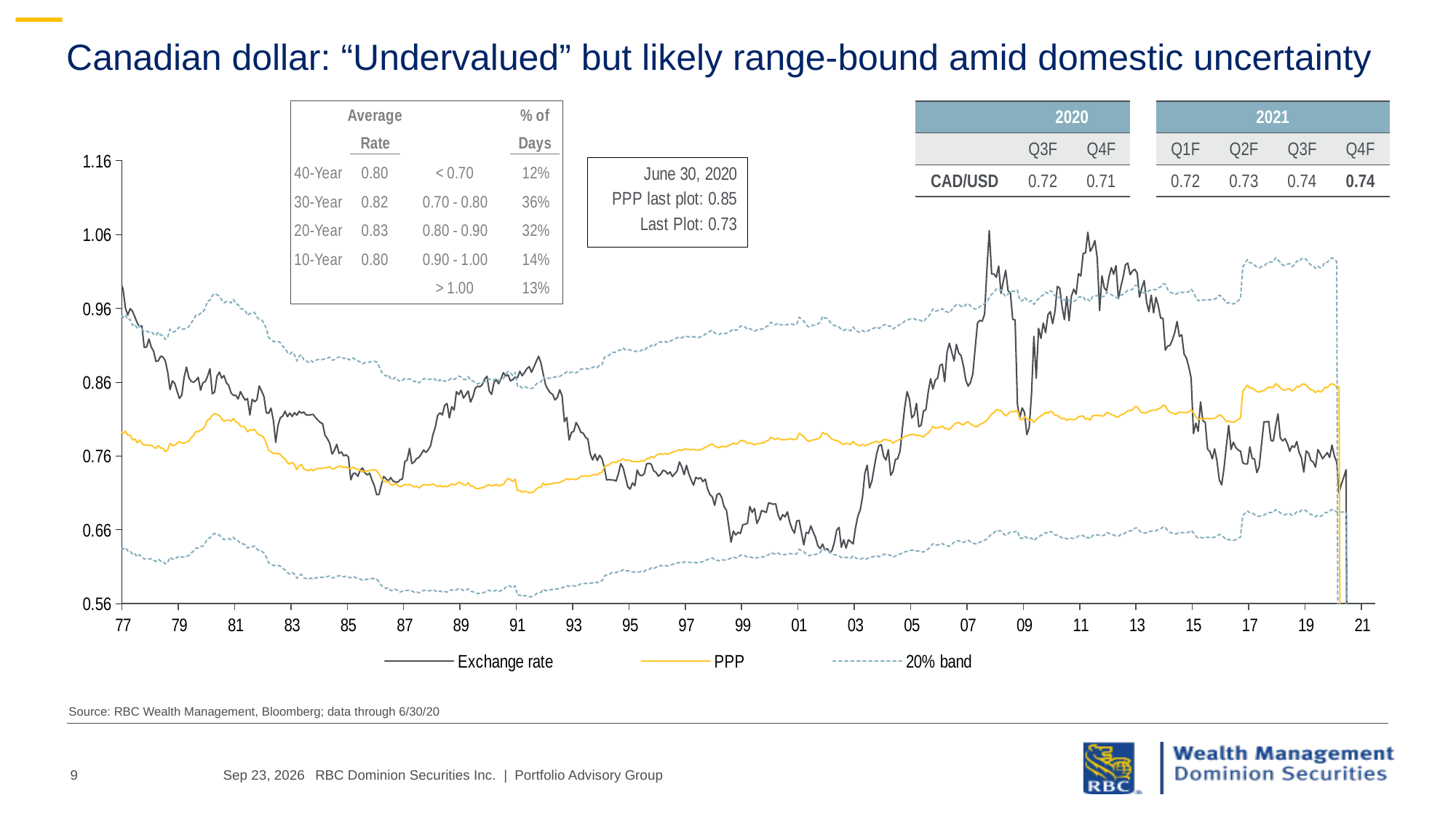
What kind of chart is shown on the slide? line chart According to the annotation box, what is the PPP last plot value as of June 30, 2020? 0.85 What are the three series named in the chart legend? Exchange rate, PPP, 20% band Does the exchange rate generally rise or fall between 2002 and 2007? rise In the table of average rates, what is the 40-year average rate? 0.80 Which is larger at the last plot, the PPP value or the exchange rate value? PPP How many series does the chart legend list? 3 Is the exchange rate at its low around 2002 greater or less than 0.66? less What colour is the PPP line on the chart? yellow Is the exchange rate at its peak around 2011 greater or less than 0.96? greater What is the difference between the PPP last plot (0.85) and the exchange rate last plot (0.73)? 0.12 According to the annotation box, what is the last plot value of the exchange rate as of June 30, 2020? 0.73